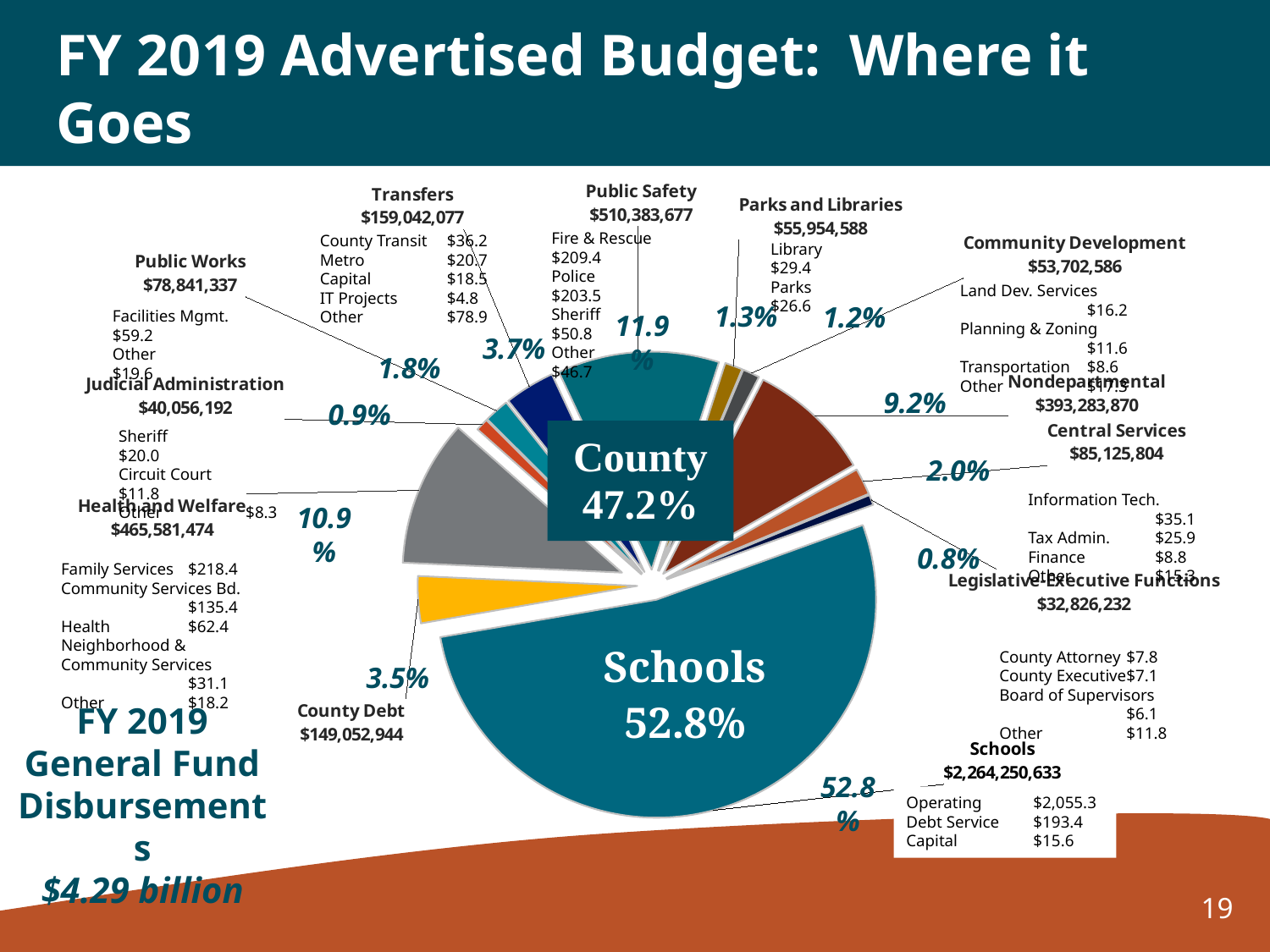
What is the dollar amount shown for Health and Welfare? $465,581,474 What percentage of the pie is County Debt? 3.5% What share of the FY 2019 General Fund Disbursements goes to Schools? 52.8% What is the dollar amount shown for Public Safety? $510,383,677 Which category has the largest slice of the pie? Schools What is the difference in percentage points between the Public Safety slice (11.9%) and the Health and Welfare slice (10.9%)? 1.0 What percentage of the pie is Nondepartmental? 9.2% What kind of chart is shown on the slide? pie chart Which is larger, the Transfers slice or the County Debt slice? Transfers Which of the labeled county categories has the smallest share of the pie? Legislative-Executive Functions What total amount does the slide give for the FY 2019 General Fund Disbursements? $4.29 billion